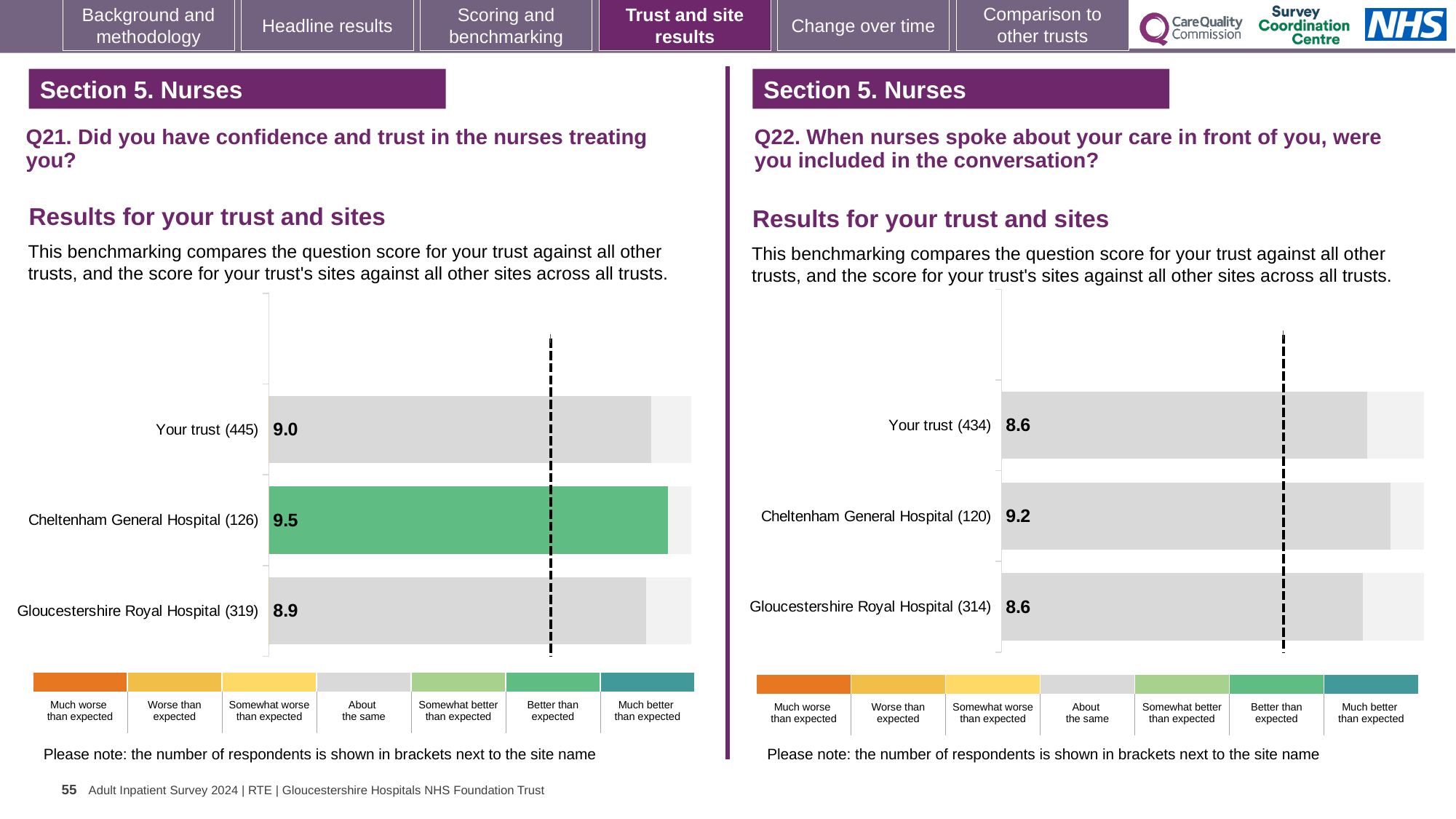
What kind of chart is used in the Q21 chart on the left? Bar chart In the Q21 chart on the left, which bar is coloured green rather than grey? Cheltenham General Hospital In the Q21 chart on the left, which site or trust has the highest score? Cheltenham General Hospital In the Q22 chart on the right, what is the score for Your trust? 8.6 In the Q22 chart on the right, what is the difference between the scores for Cheltenham General Hospital and Your trust? 0.6 In the Q21 chart on the left, what is the difference between the scores for Cheltenham General Hospital and Gloucestershire Royal Hospital? 0.6 In the Q21 chart on the left, how many bars are plotted? 3 In the Q22 chart on the right, what is the score for Cheltenham General Hospital? 9.2 In the Q22 chart on the right, which site has the highest score? Cheltenham General Hospital In the Q21 chart on the left, what is the score for Gloucestershire Royal Hospital? 8.9 In the Q21 chart on the left, what is the score for Cheltenham General Hospital? 9.5 In the Q21 chart on the left, what is the score for Your trust? 9.0